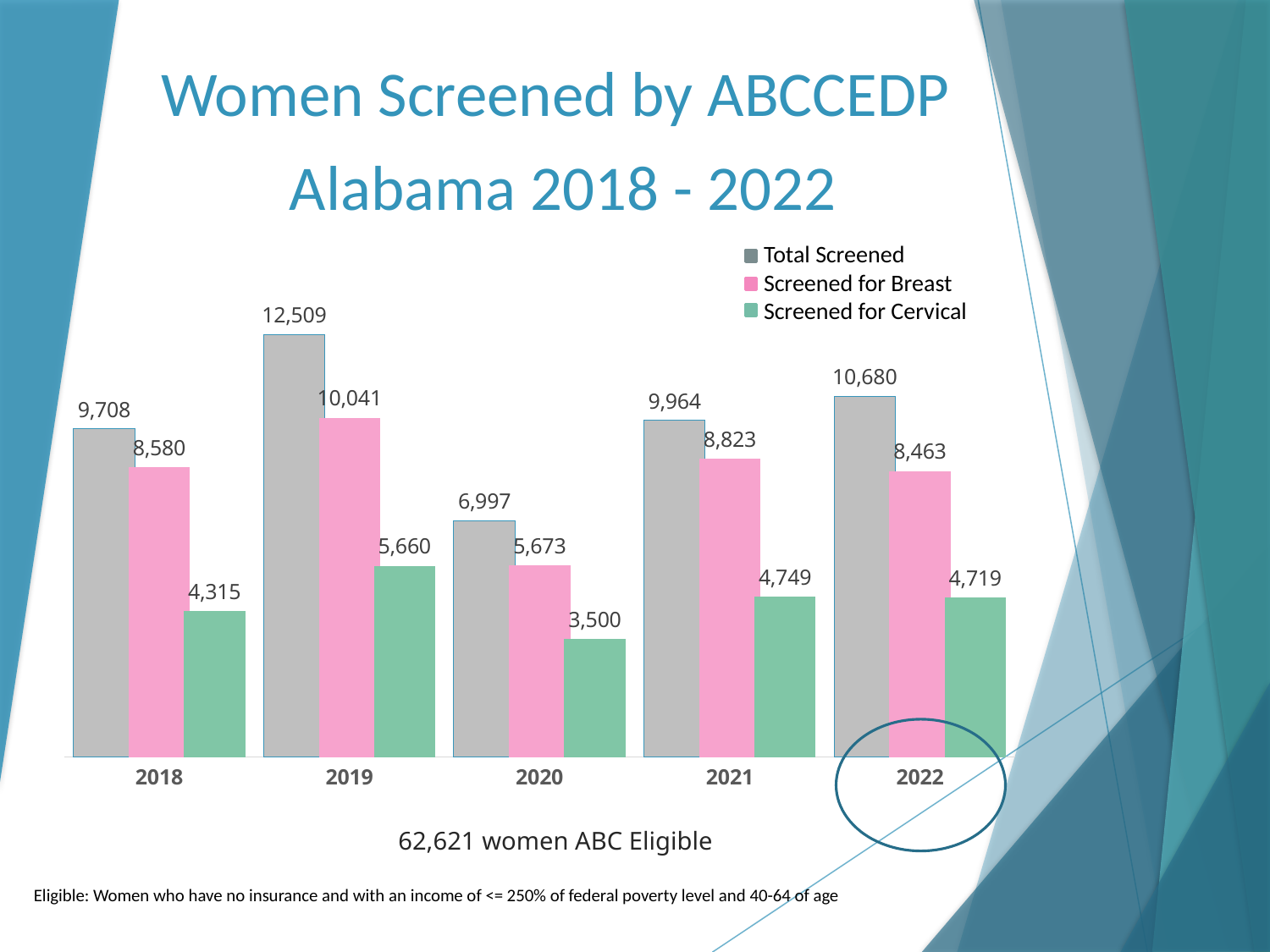
What was the Total Screened value in 2019? 12,509 Which year had the highest Total Screened value? 2019 How many women were Screened for Cervical in 2020? 3,500 Which colour represents the Screened for Cervical series? Green Which year had the lowest Screened for Cervical value? 2020 What was the Screened for Breast value in 2022? 8,463 Did the Total Screened value rise or fall from 2019 to 2020? Fall How many series does the legend list? 3 How many years are shown on the x axis? 5 What kind of chart is shown on the slide? Bar chart What is the difference between Total Screened in 2019 and Total Screened in 2020? 5,512 Which is larger: Screened for Breast in 2021 or Screened for Breast in 2022? Screened for Breast in 2021